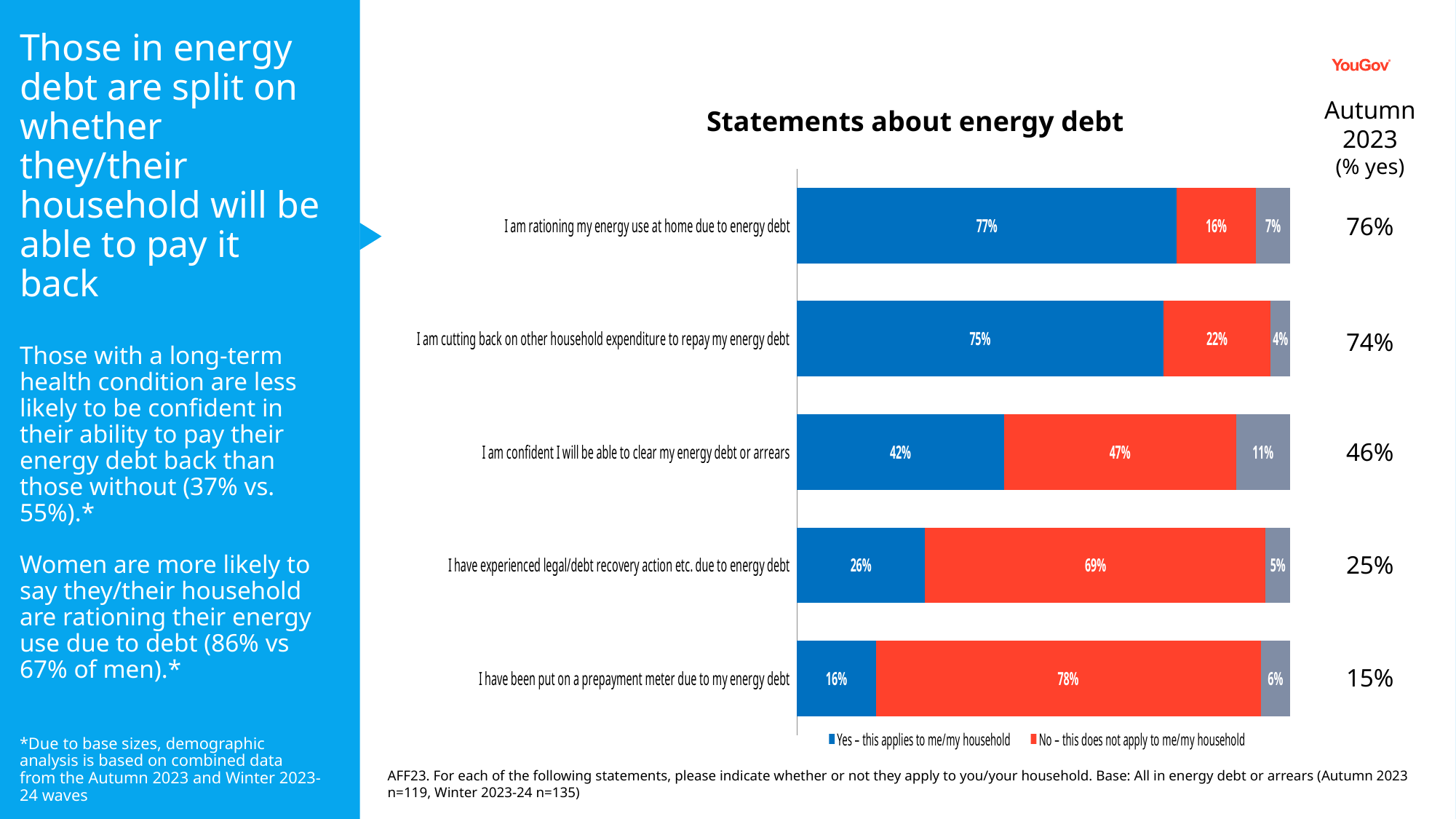
What is the difference between the 'No' percentage and the 'Yes' percentage for 'I have experienced legal/debt recovery action etc. due to energy debt'? 43% What percentage say 'Yes' to 'I am rationing my energy use at home due to energy debt'? 77% How many series does the chart legend list? 2 What percentage say 'No' to 'I have been put on a prepayment meter due to my energy debt'? 78% Is the 'Yes' percentage larger for 'I am cutting back on other household expenditure to repay my energy debt' or for 'I am confident I will be able to clear my energy debt or arrears'? I am cutting back on other household expenditure to repay my energy debt Which statement has the highest 'Yes' percentage? I am rationing my energy use at home due to energy debt What is the Autumn 2023 '% yes' figure shown for 'I am confident I will be able to clear my energy debt or arrears'? 46% How many statements are shown in the chart? 5 What is the title of the chart? Statements about energy debt What percentage say 'No' to 'I am confident I will be able to clear my energy debt or arrears'? 47% What kind of chart is shown on the slide? Stacked bar chart Which statement has the lowest 'Yes' percentage? I have been put on a prepayment meter due to my energy debt